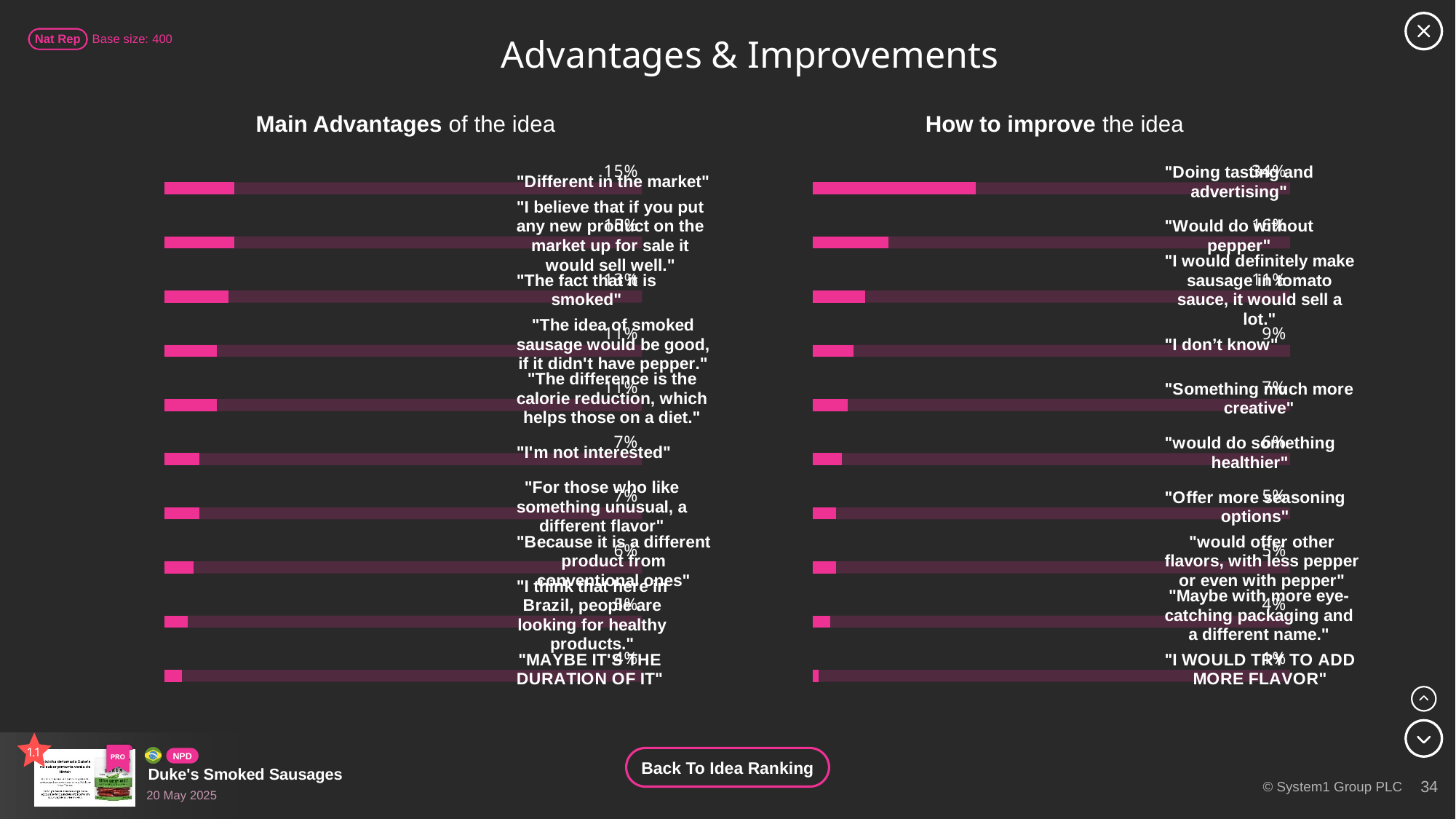
On the "Main Advantages of the idea" chart, which is larger: "I'm not interested" or "MAYBE IT'S THE DURATION OF IT"? "I'm not interested" On the "How to improve the idea" chart, do the values rise or fall from the top bar to the bottom bar? Fall On the "How to improve the idea" chart, what is the difference between "Doing tasting and advertising" and "I don't know"? 25% On the "How to improve the idea" chart, which category has the highest value? "Doing tasting and advertising" On the "Main Advantages of the idea" chart, what is the value for "Different in the market"? 15% What kind of chart is the "Main Advantages of the idea" chart? Bar chart On the "How to improve the idea" chart, what is the value for "I don't know"? 9% On the "How to improve the idea" chart, what is the value for "Something much more creative"? 7% On the "Main Advantages of the idea" chart, what is the value for "I'm not interested"? 7% On the "Main Advantages of the idea" chart, which category has the lowest value? "MAYBE IT'S THE DURATION OF IT" On the "How to improve the idea" chart, which category has the lowest value? "I WOULD TRY TO ADD MORE FLAVOR" How many bars are shown on the "How to improve the idea" chart? 10